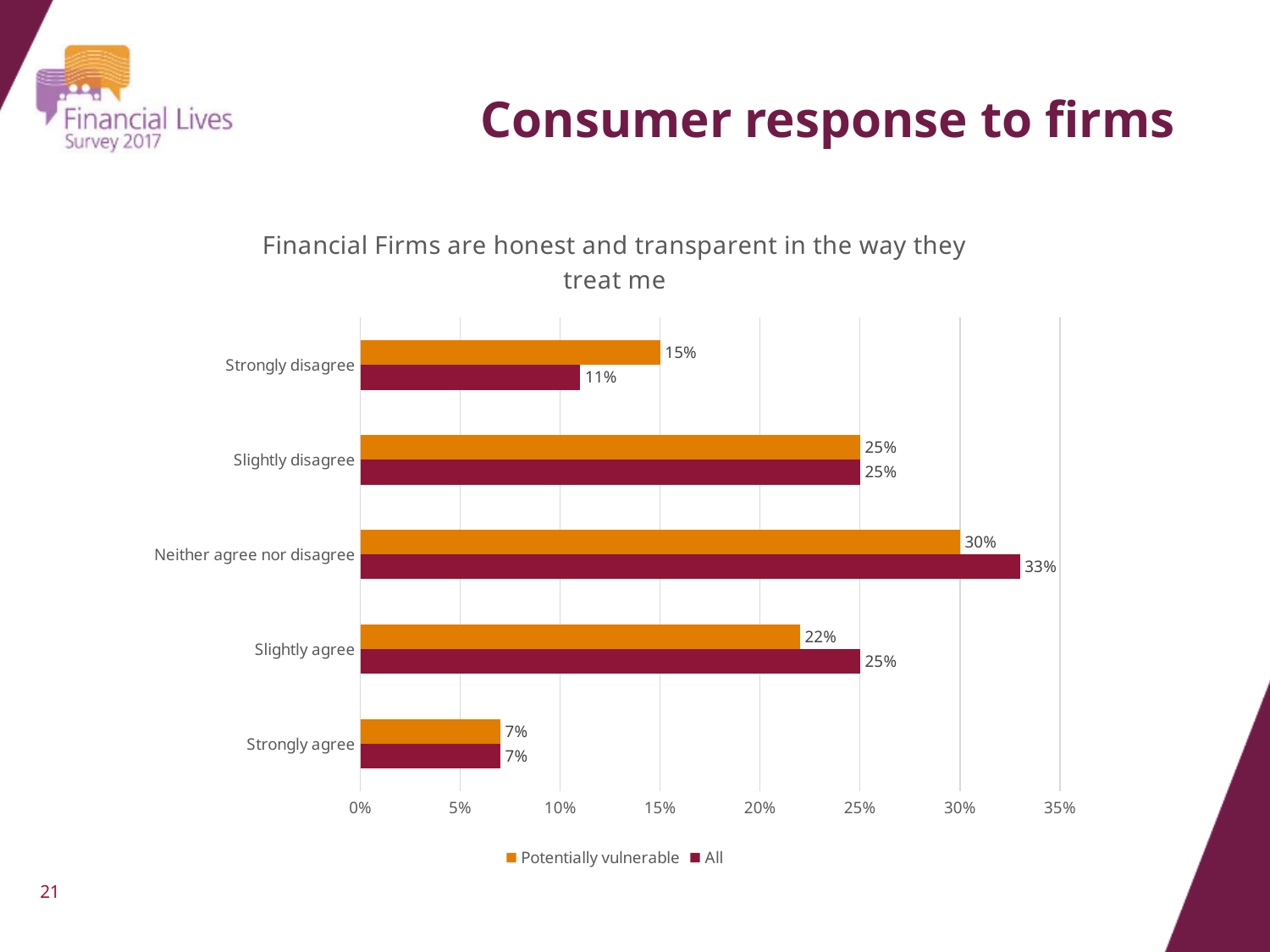
What is the value for 'All' in the 'Neither agree nor disagree' category? 33% Which category has the lowest value for the 'Potentially vulnerable' series? Strongly agree What is the difference between the 'Potentially vulnerable' and 'All' values for 'Strongly disagree'? 4% What is the value for 'Potentially vulnerable' in the 'Strongly disagree' category? 15% Which category has the highest value for the 'All' series? Neither agree nor disagree What is the title of the chart? Financial Firms are honest and transparent in the way they treat me What is the difference between the 'All' and 'Potentially vulnerable' values for 'Neither agree nor disagree'? 3% What is the value for 'All' in the 'Slightly agree' category? 25% How many series does the legend list? 2 What kind of chart is shown on the slide? Bar chart For 'Slightly agree', which series has the larger value, 'Potentially vulnerable' or 'All'? All How many response categories are shown on the chart? 5